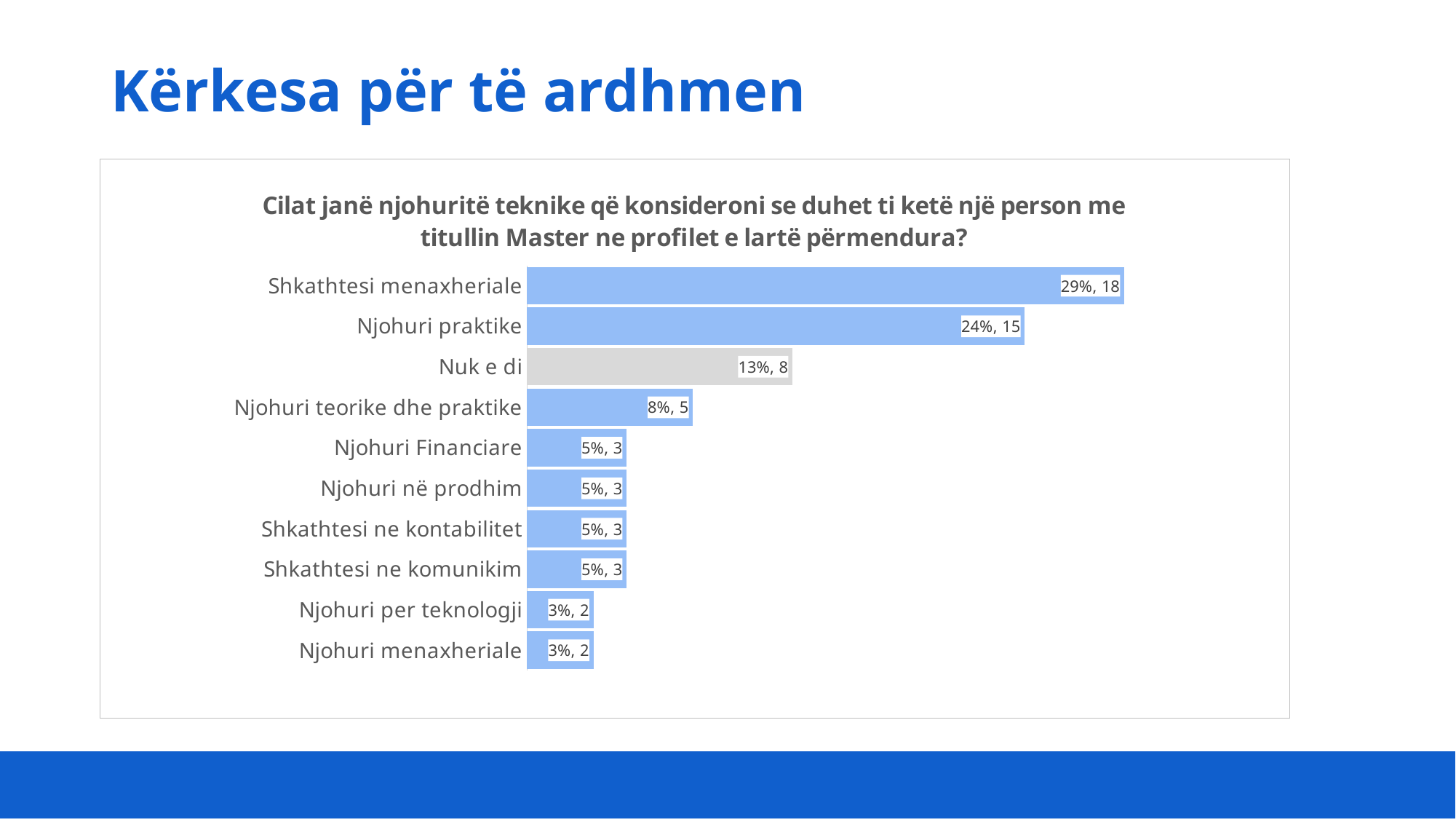
Which category has the highest value? Shkathtesi menaxheriale Which is larger, the value for Njohuri praktike or the value for Nuk e di? Njohuri praktike What is the difference in percentage between Nuk e di and Njohuri teorike dhe praktike? 5% Which bar is shown in a different colour (grey) from the others? Nuk e di What is the data label for Njohuri praktike? 24%, 15 What kind of chart is shown on the slide? bar chart What is the data label for Nuk e di? 13%, 8 What is the data label for Njohuri teorike dhe praktike? 8%, 5 What is the data label for Njohuri per teknologji? 3%, 2 What is the difference in count between Shkathtesi menaxheriale and Njohuri praktike? 3 What is the data label for Shkathtesi menaxheriale? 29%, 18 How many categories does the chart show? 10